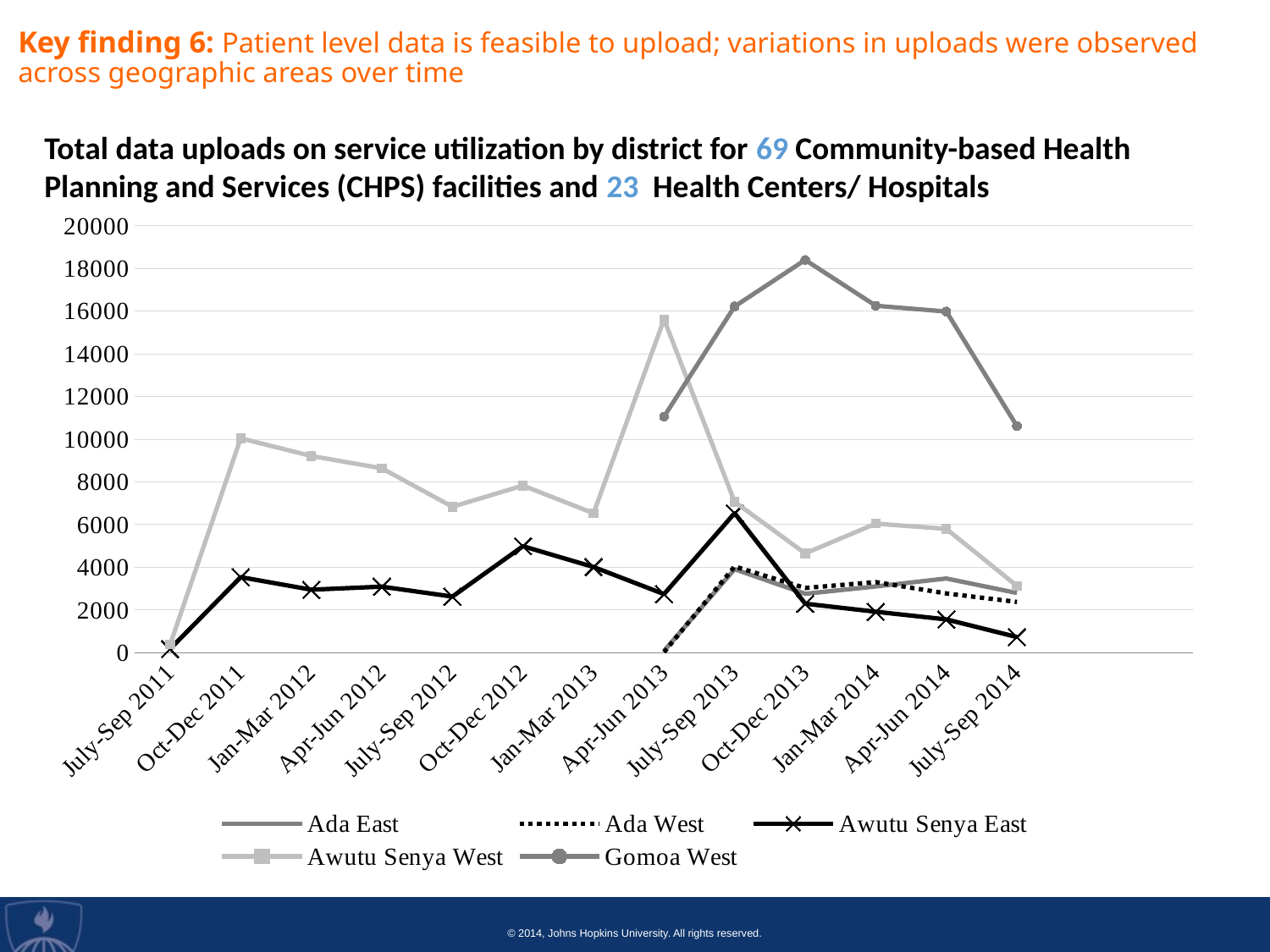
What kind of chart is shown on the slide? line chart How many series does the legend list? 5 Does the Gomoa West line rise or fall from Oct-Dec 2013 to July-Sep 2014? fall In which period does Gomoa West reach its peak? Oct-Dec 2013 Is the value for Awutu Senya East in July-Sep 2014 greater or less than 2000? less In Oct-Dec 2013, which is larger: Gomoa West or Awutu Senya West? Gomoa West Which series is drawn with a dotted line? Ada West How many time periods are shown on the x axis? 13 In which period does Awutu Senya West reach its peak? Apr-Jun 2013 Is the value for Awutu Senya West in Apr-Jun 2013 greater or less than 14000? greater Is the value for Gomoa West in Oct-Dec 2013 greater or less than 16000? greater Which series reaches the highest value anywhere on the chart? Gomoa West